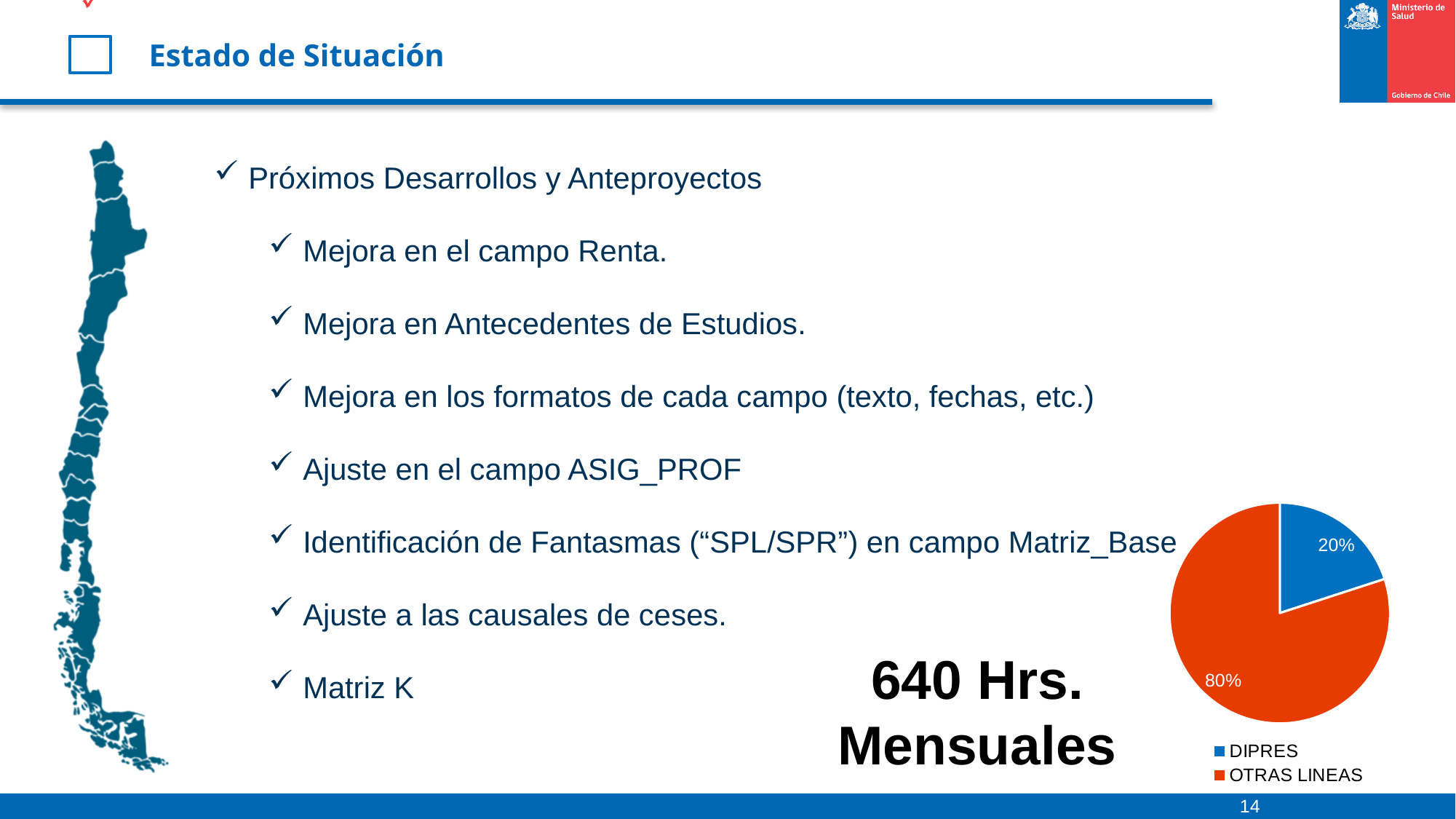
What share of the pie does OTRAS LINEAS represent? 80% Which slice of the pie is the largest? OTRAS LINEAS Which slice of the pie is the smallest? DIPRES What kind of chart is shown on the slide? pie chart What colour is the OTRAS LINEAS slice? orange What colour is the DIPRES slice? blue What is the difference in percentage points between the OTRAS LINEAS slice and the DIPRES slice? 60 How many entries does the legend list? 2 Which is larger, the DIPRES slice or the OTRAS LINEAS slice? OTRAS LINEAS What share of the pie does DIPRES represent? 20% How many slices does the pie chart have? 2